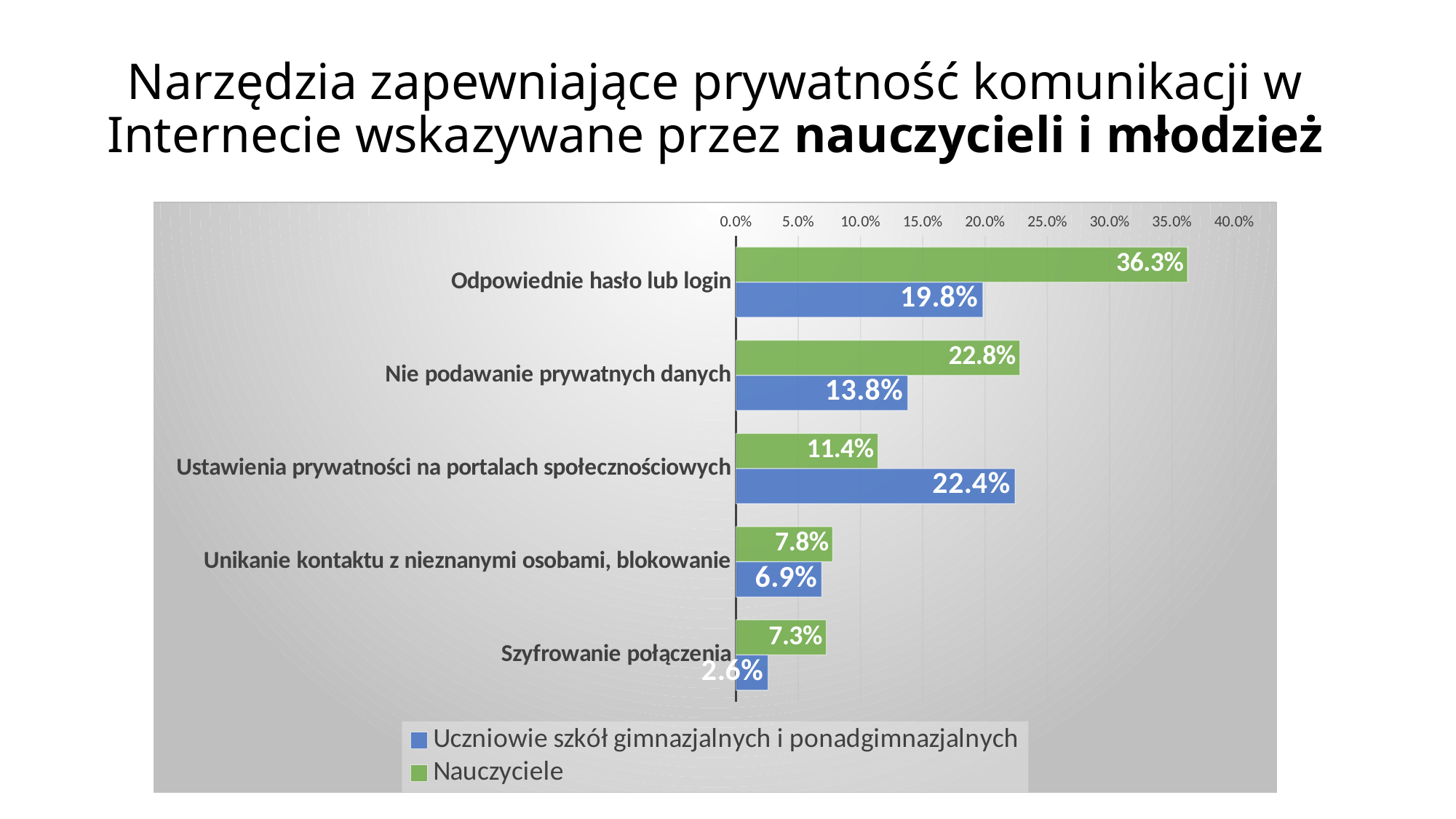
What is the difference between the Nauczyciele and Uczniowie values for 'Odpowiednie hasło lub login'? 16.5% What value do Uczniowie szkół gimnazjalnych i ponadgimnazjalnych give for 'Ustawienia prywatności na portalach społecznościowych'? 22.4% Which colour represents Nauczyciele in the chart? green For 'Ustawienia prywatności na portalach społecznościowych', which group has the larger value: Nauczyciele or Uczniowie? Uczniowie szkół gimnazjalnych i ponadgimnazjalnych What kind of chart is shown on the slide? bar chart How many categories are shown on the chart? 5 Which category has the highest value for Nauczyciele? Odpowiednie hasło lub login How many series does the legend list? 2 What value do Nauczyciele give for 'Odpowiednie hasło lub login'? 36.3% Is the Nauczyciele value for 'Nie podawanie prywatnych danych' greater or less than 20.0%? greater What value do Uczniowie szkół gimnazjalnych i ponadgimnazjalnych give for 'Szyfrowanie połączenia'? 2.6% Which category has the lowest value for Uczniowie szkół gimnazjalnych i ponadgimnazjalnych? Szyfrowanie połączenia